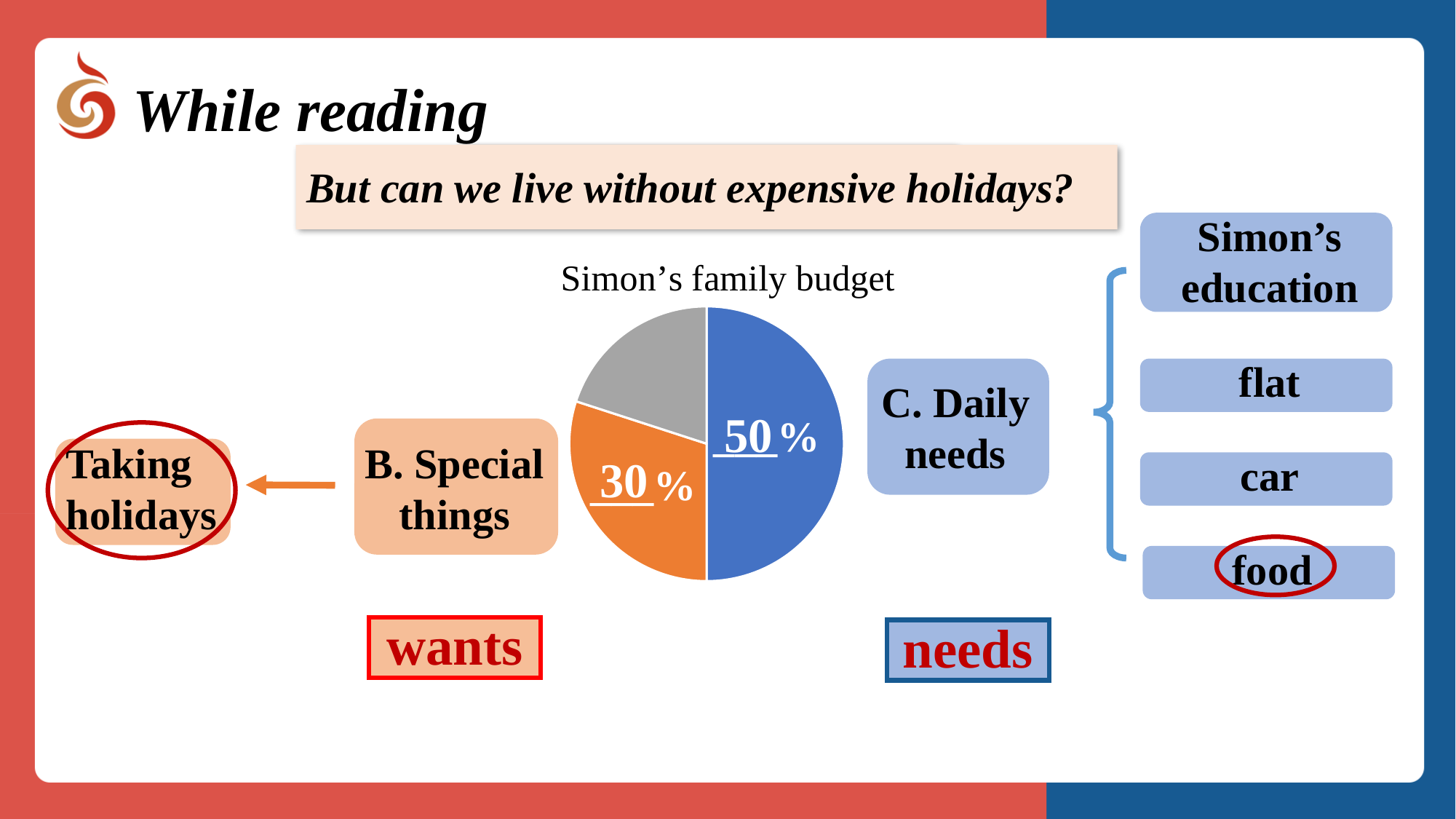
Which slice of the pie chart has no percentage label? the gray slice Which is larger in the pie chart, the blue slice or the orange slice? the blue slice What percentage is printed on the blue slice of the pie chart? 50 % What share of the pie does the orange slice represent? 30 % What kind of chart is shown on the slide? pie chart What is the title of the pie chart? Simon's family budget Which slice of the pie chart is the smallest? the gray slice What is the difference between the percentages printed on the blue slice and the orange slice? 20 % How many slices does the pie chart have? 3 How many slices of the pie chart have a percentage label printed on them? 2 Which slice of the pie chart is the largest? the blue slice What percentage is printed on the orange slice of the pie chart? 30 %